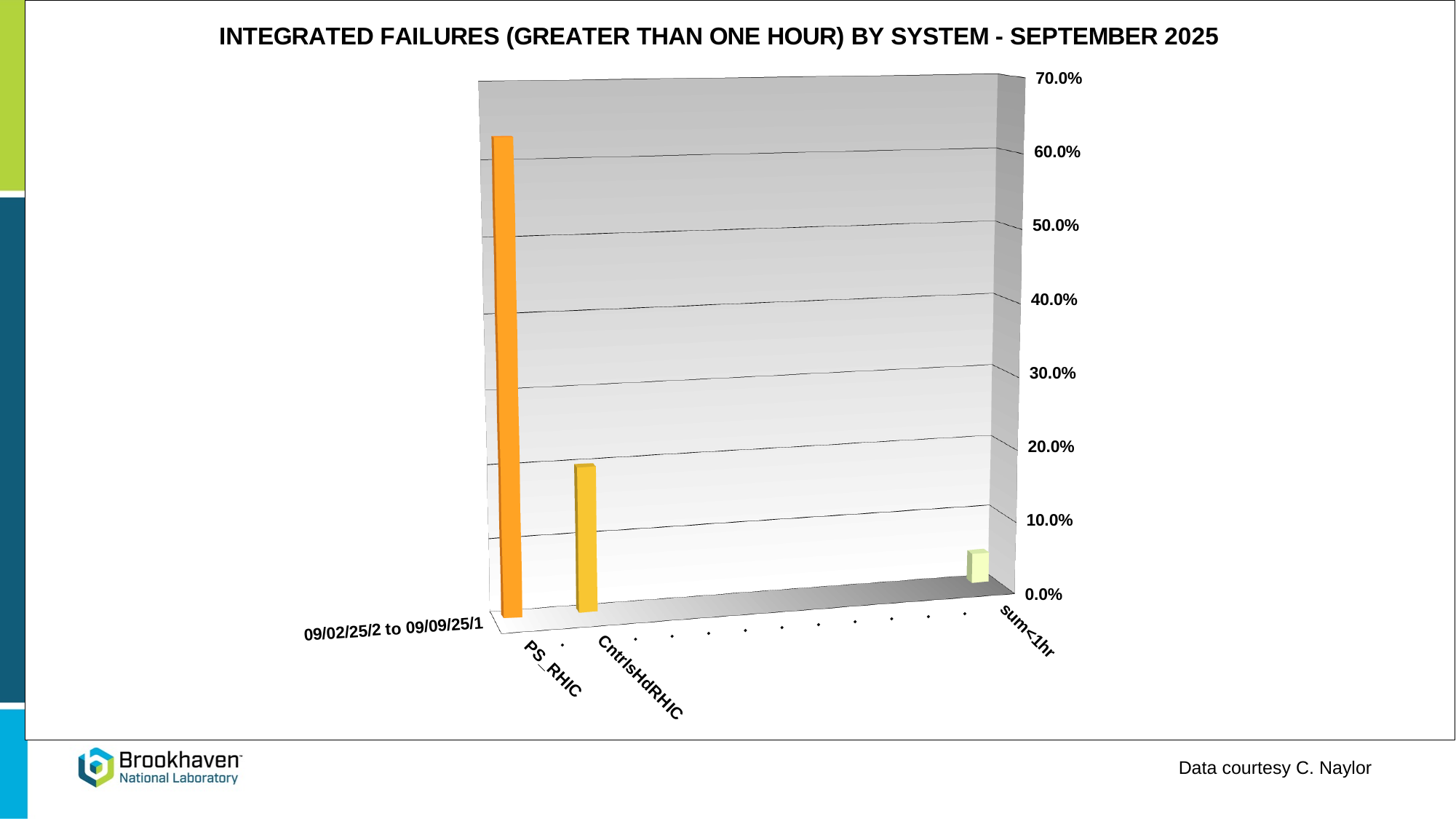
Which is larger, the value for PS_RHIC or the value for CntrlsHdRHIC? PS_RHIC Which is larger, the value for CntrlsHdRHIC or the value for sum<1hr? CntrlsHdRHIC Is the value for CntrlsHdRHIC greater or less than 10.0%? greater What kind of chart is shown on the slide? bar chart Which labeled category has the lowest bar? sum<1hr What is the highest value shown on the vertical axis? 70.0% How many categories have readable labels on the x axis? 3 Is the value for PS_RHIC greater or less than 60.0%? greater Which system has the highest bar? PS_RHIC What is the title of the chart? INTEGRATED FAILURES (GREATER THAN ONE HOUR) BY SYSTEM - SEPTEMBER 2025 Is the value for sum<1hr greater or less than 10.0%? less